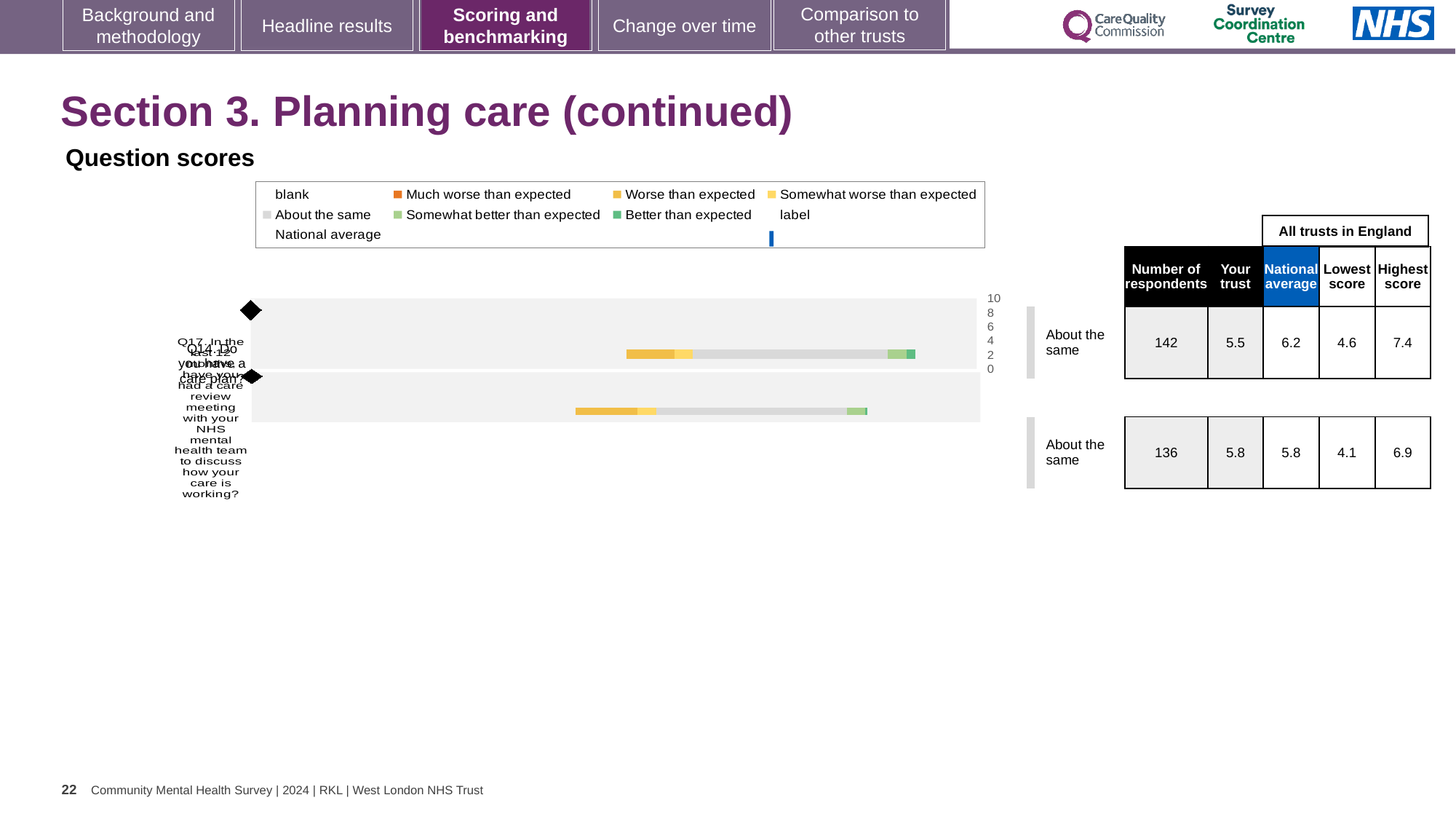
What is the difference in number of respondents between the top row and the bottom row? 6 How many question bars are plotted in the chart? 2 In the table beside the chart, what is the number of respondents for the top row? 142 In the table beside the chart, what is the highest score for the bottom row? 6.9 Which row has more respondents, the top row or the bottom row? Top row In the table beside the chart, what is the national average for the top row? 6.2 What kind of chart is shown under 'Question scores'? bar chart For the top row, which is larger: the 'Your trust' score or the national average? National average For the top row, what is the difference between the highest score and the lowest score? 2.8 In the table beside the chart, what is the 'Your trust' score for the top row? 5.5 In the table beside the chart, what is the lowest score for the bottom row? 4.1 What benchmark category is shown next to both bars in the chart? About the same